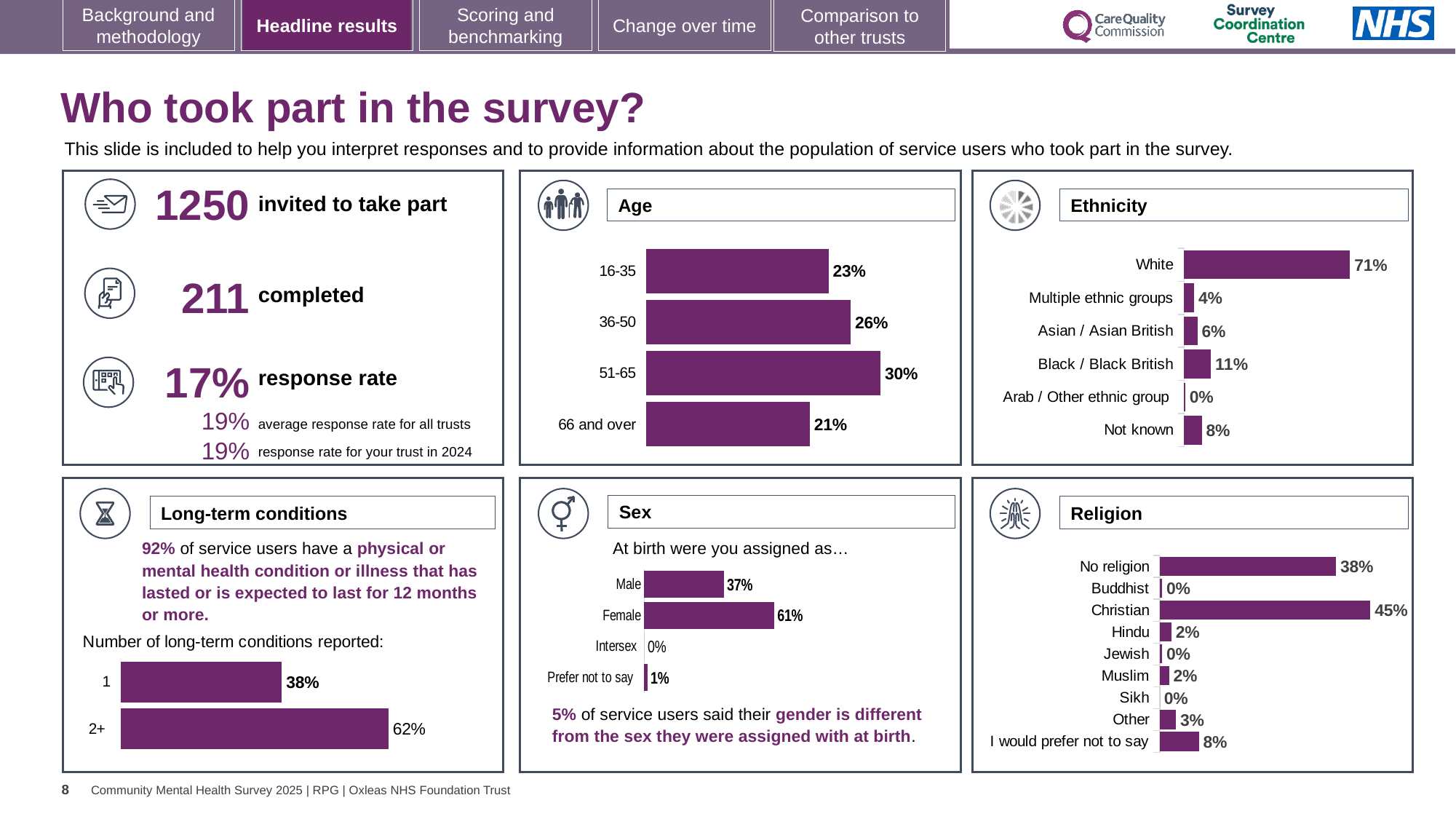
In the Age chart, which age group has the lowest percentage? 66 and over In the Sex chart, what is the value for Prefer not to say? 1% In the Age chart, what percentage of respondents were aged 51-65? 30% In the Ethnicity chart, how many categories are shown? 6 In the Religion chart, how many categories are shown? 9 What type of chart is used in the Age panel? Bar chart In the Religion chart, which category has the highest percentage? Christian In the Ethnicity chart, which category has the highest percentage? White In the Religion chart, what is the value for I would prefer not to say? 8% In the Long-term conditions chart, which is larger, the value for 1 condition or for 2+ conditions? 2+ In the Sex chart, what is the difference between the Female and Male percentages? 24% In the Ethnicity chart, what is the value for Black / Black British? 11%